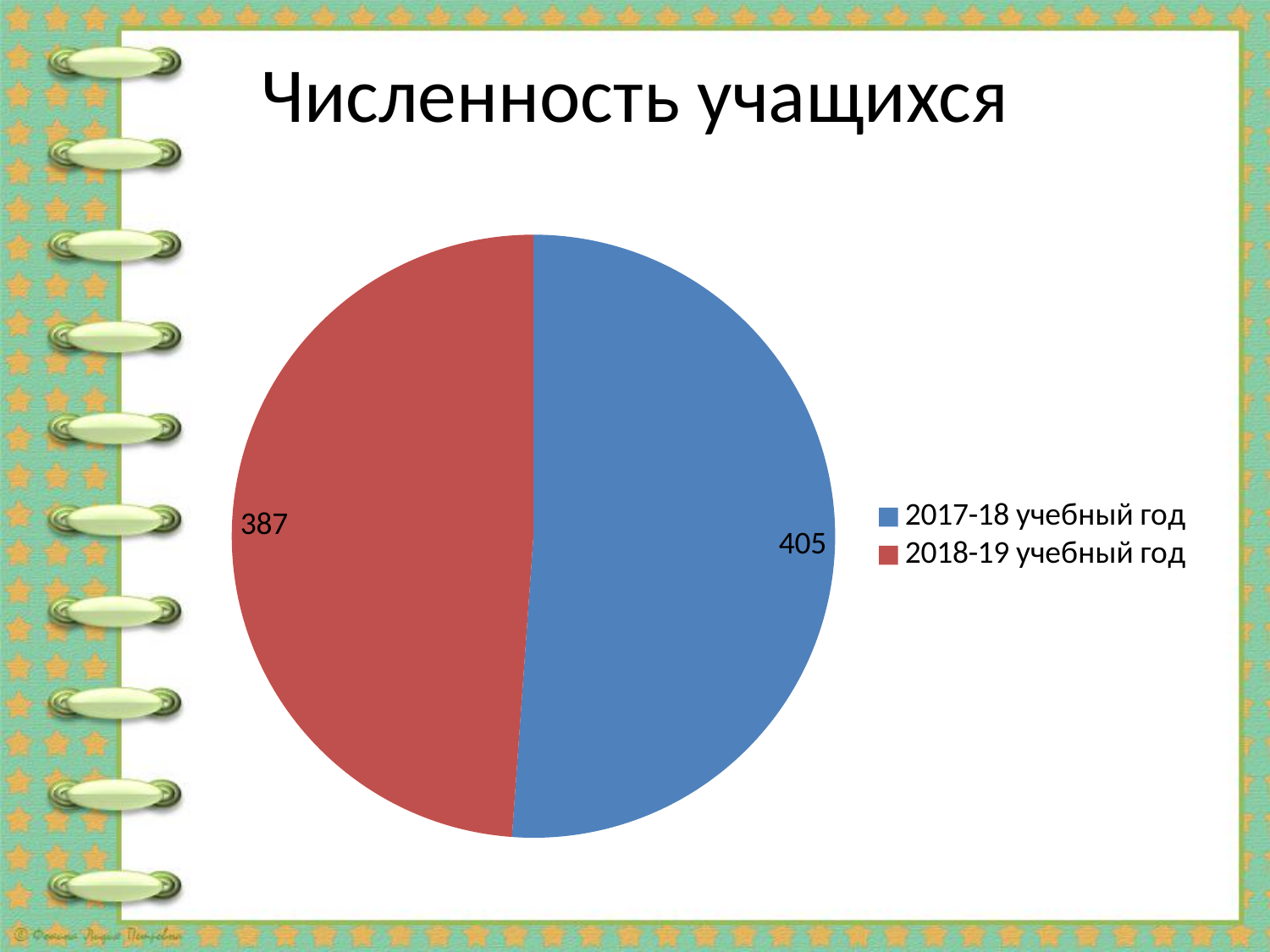
What is the title of the slide? Численность учащихся What is the value for 2017-18 учебный год? 405 What is the value for 2018-19 учебный год? 387 Which school year has the larger number of students? 2017-18 учебный год What kind of chart is shown on the slide? pie chart Is the value for 2017-18 учебный год larger or smaller than the value for 2018-19 учебный год? larger How many slices does the pie chart have? 2 How many entries does the legend list? 2 Which school year has the smaller number of students? 2018-19 учебный год What is the total of the two values shown in the pie chart? 792 Which colour represents 2018-19 учебный год in the pie chart? red What is the difference between the values for 2017-18 учебный год and 2018-19 учебный год? 18